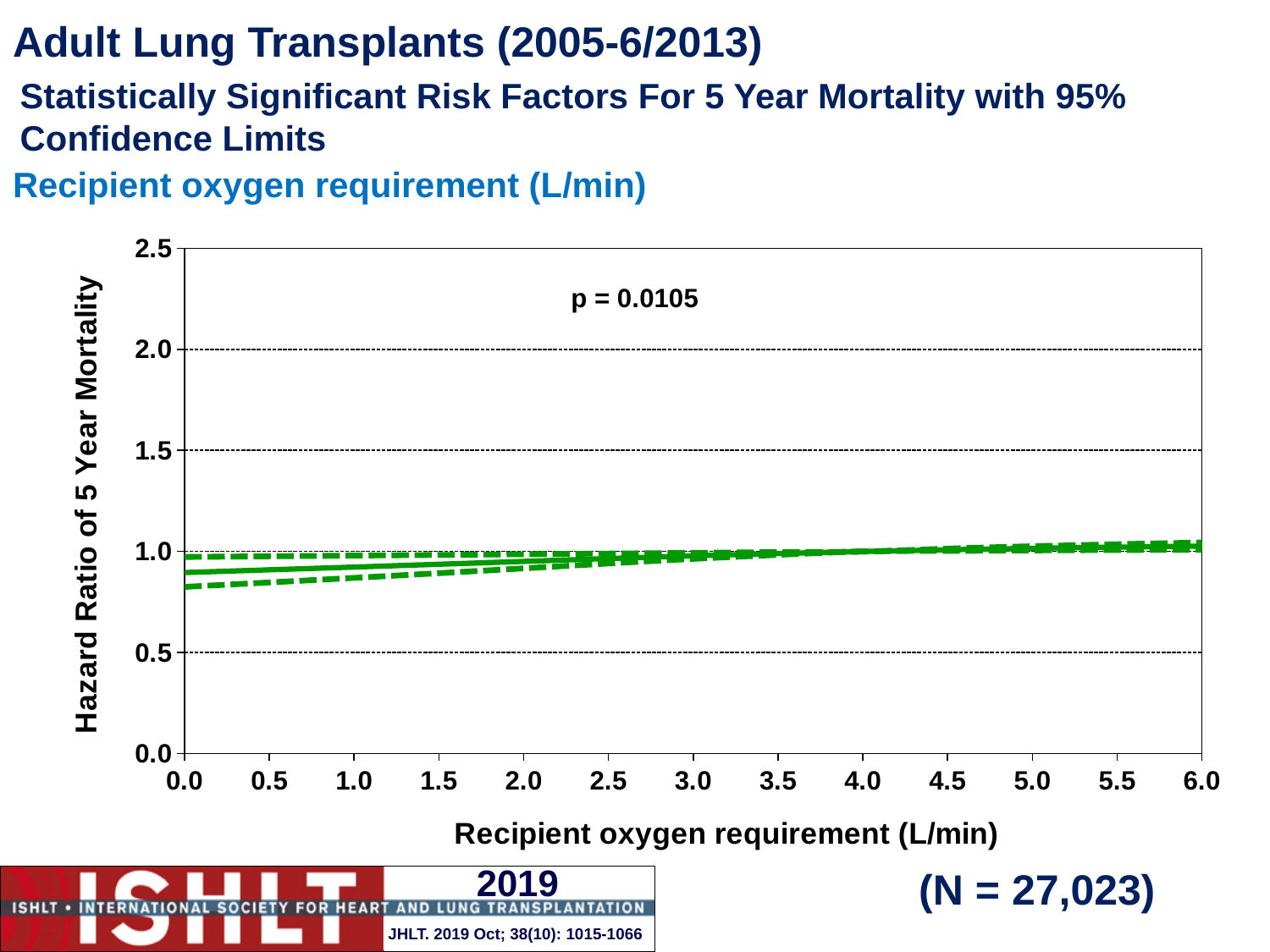
What p-value is printed on the chart? p = 0.0105 What is the highest value labelled on the y axis? 2.5 What is the label of the x axis? Recipient oxygen requirement (L/min) Which is larger, the hazard ratio of 5 year mortality at 0.0 L/min or at 6.0 L/min? 6.0 L/min What kind of chart is shown on the slide? line chart Is the lower 95% confidence limit at a recipient oxygen requirement of 0.0 L/min greater or less than 0.5? greater Does the hazard ratio of 5 year mortality rise or fall as recipient oxygen requirement increases from 0.0 to 6.0 L/min? rise Is the upper 95% confidence limit at a recipient oxygen requirement of 1.0 L/min greater or less than 1.5? less Is the hazard ratio of 5 year mortality at a recipient oxygen requirement of 0.0 L/min greater or less than 1.0? less How many tick marks are labelled on the x axis? 13